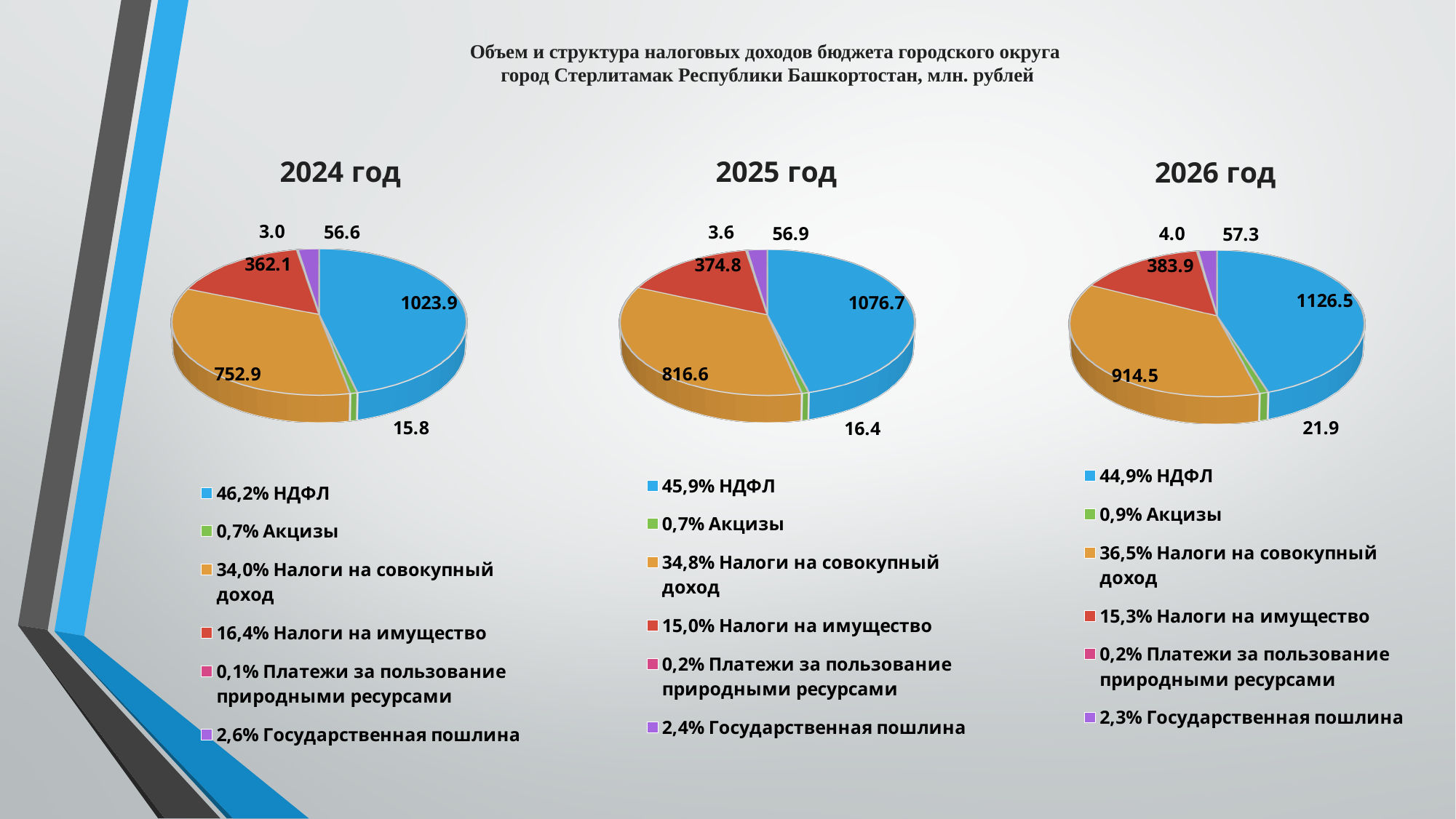
In the 2026 год chart, what is the value for Налоги на имущество? 383.9 In the 2025 год chart, which is larger: Налоги на имущество or Государственная пошлина? Налоги на имущество How many categories does the legend of the 2024 год chart list? 6 In the 2025 год chart, what is the value for Налоги на совокупный доход? 816.6 In the 2024 год chart, which category has the smallest value? Платежи за пользование природными ресурсами In the 2024 год chart, what is the value for НДФЛ? 1023.9 In the 2026 год chart, what is the value for Акцизы? 21.9 In the 2026 год chart, what is the difference between the НДФЛ value and the Налоги на совокупный доход value? 212.0 What kind of chart is used for the 2024 год data? pie chart According to the legend of the 2026 год chart, what share of the pie is Налоги на совокупный доход? 36,5% According to the legend of the 2025 год chart, what share of the pie is НДФЛ? 45,9% In the 2025 год chart, which category has the largest slice? НДФЛ